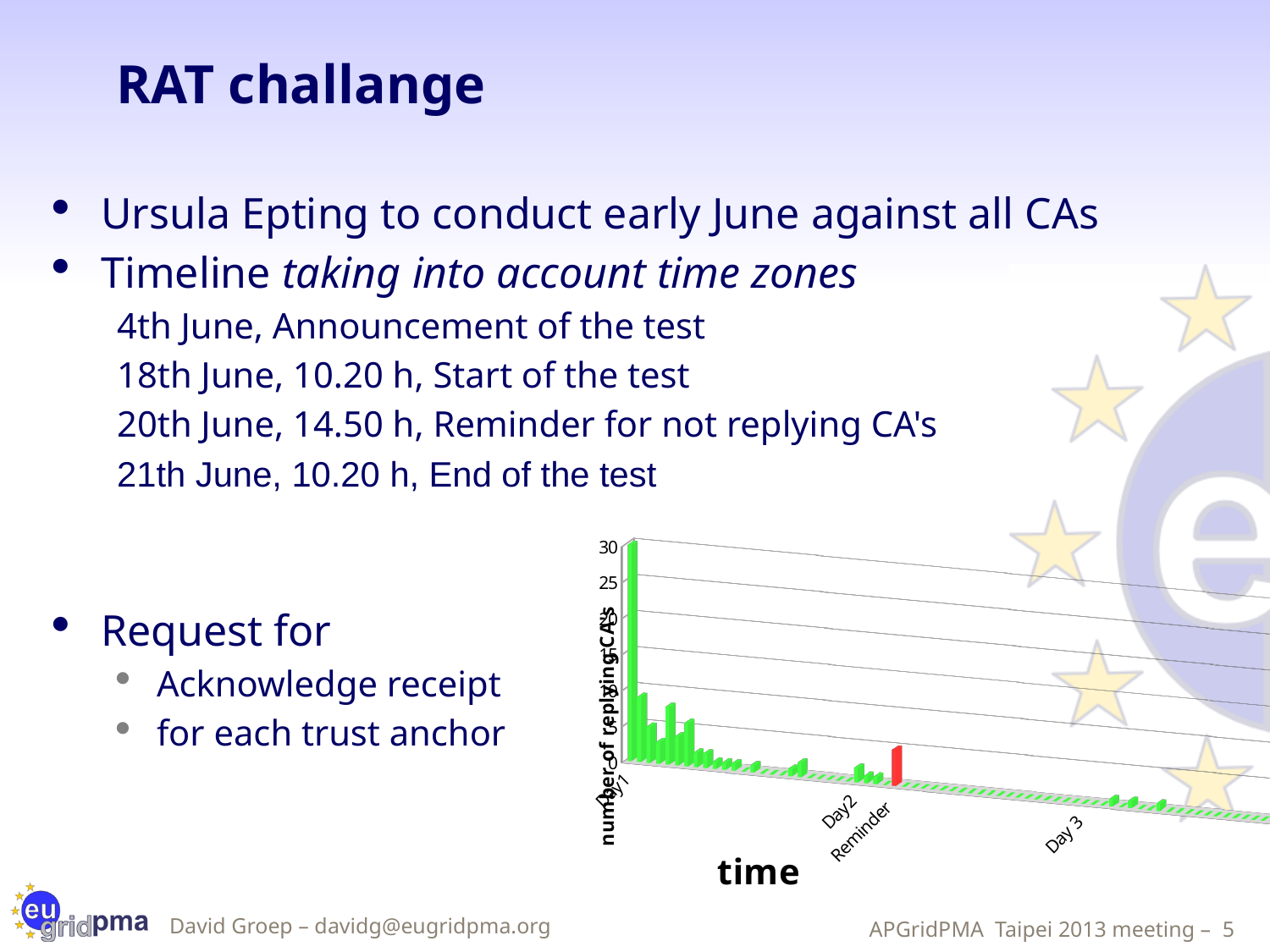
Do the bar heights generally rise or fall along the time axis from Day 1 to Day 3? fall Is the tallest bar on Day 1 larger or smaller than the red bar at the Reminder? larger Is the value of the tallest bar on Day 1 greater or less than 20? greater Which day has the tallest bar in the chart? Day1 What is the title of the x axis of the chart? time What is the title of the y axis of the chart? number of replying CA's Is the value of the tallest bar on Day 3 greater or less than 5? less What is the highest value shown on the y axis of the chart? 30 What kind of chart is shown on the slide? bar chart Is the value of the red bar at the Reminder greater or less than 10? less